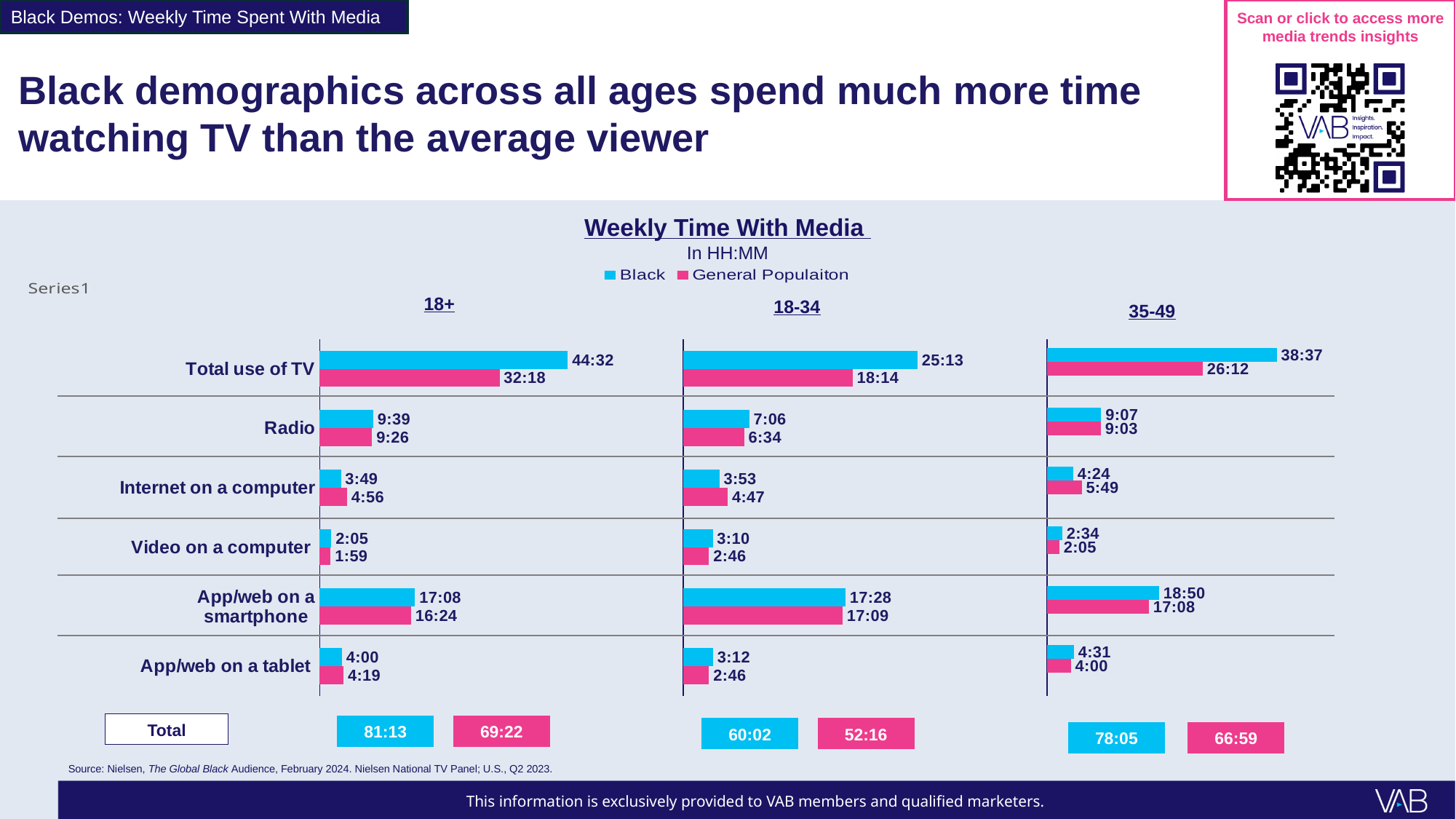
How many series does the legend list for the Weekly Time With Media charts? 2 In the 35-49 chart, what is the Black value for App/web on a smartphone? 18:50 What is the Total weekly time for Black viewers in the 18-34 chart? 60:02 How many categories are shown in the 18-34 chart? 6 In the 35-49 chart, which is larger for Internet on a computer: the Black value or the General Population value? General Population In the 18-34 chart, which category has the lowest value for the General Population? Video on a computer and App/web on a tablet (both 2:46) What type of chart is used for the 35-49 age group? Bar chart In the 18-34 chart, what is the General Population value for Radio? 6:34 In the 18+ chart, what is the difference between the Black and General Population values for Total use of TV? 12:14 Which colour represents the Black series in the charts? Blue In the 18+ chart, which category has the highest value for Black viewers? Total use of TV In the 18+ chart, what is the weekly time for Black viewers on Total use of TV? 44:32